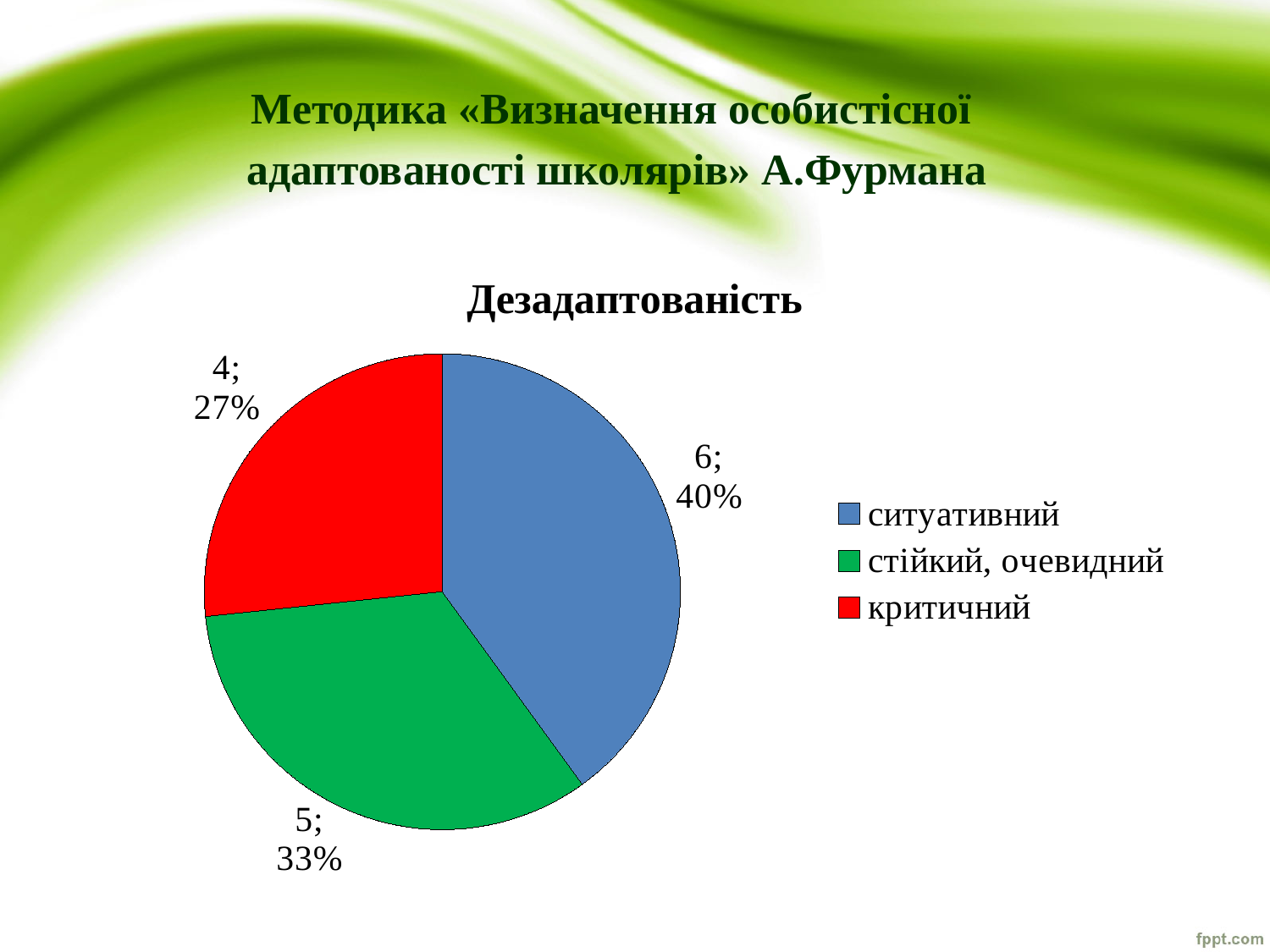
What kind of chart is shown on the slide? pie chart Which category has the smallest slice? критичний How many slices does the pie chart have? 3 What is the title of the chart? Дезадаптованість How many entries does the legend list? 3 What share of the pie does ситуативний take? 40% Which category has the largest slice? ситуативний What share of the pie does критичний take? 27% What is the difference between the values for ситуативний and критичний? 2 What is the value for ситуативний? 6 What is the value for критичний? 4 What is the value for стійкий, очевидний? 5